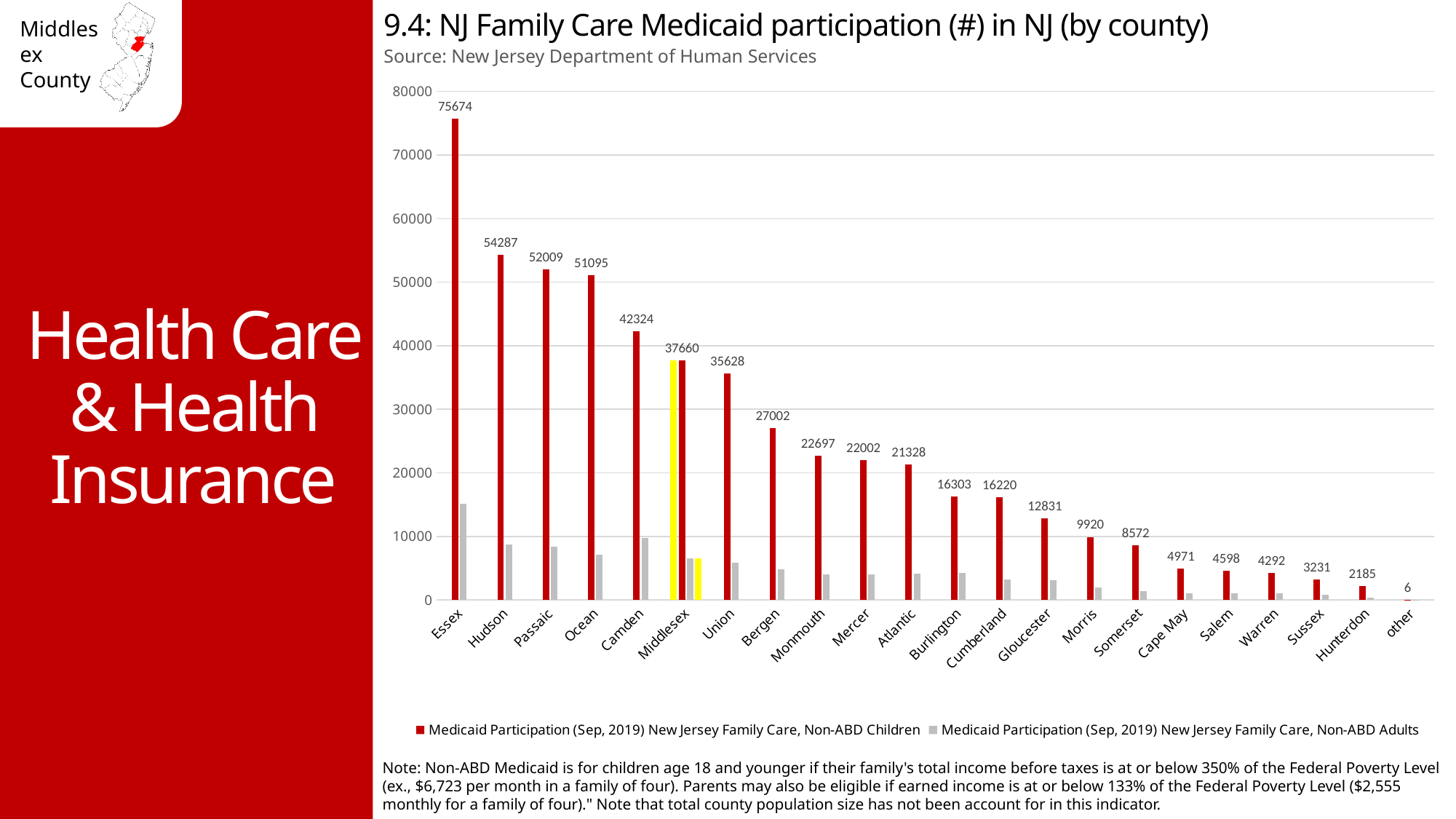
Do the Non-ABD Children values rise or fall moving from left to right along the x axis? fall What is the difference between the Non-ABD Children values for Hudson and Passaic? 2278 Which labeled county (excluding 'other') has the lowest Non-ABD Children Medicaid participation? Hunterdon What is the Non-ABD Children Medicaid participation value for Cape May? 4971 How many series does the legend list? 2 Which has a larger Non-ABD Children value, Camden or Union? Camden Which county has the highest Non-ABD Children Medicaid participation? Essex How many categories are shown on the x axis? 22 Is the Non-ABD Adults value for Essex greater or less than 10000? greater What kind of chart is shown on the slide? bar chart What is the Non-ABD Children Medicaid participation value for Essex? 75674 What is the Non-ABD Children Medicaid participation value for Middlesex? 37660